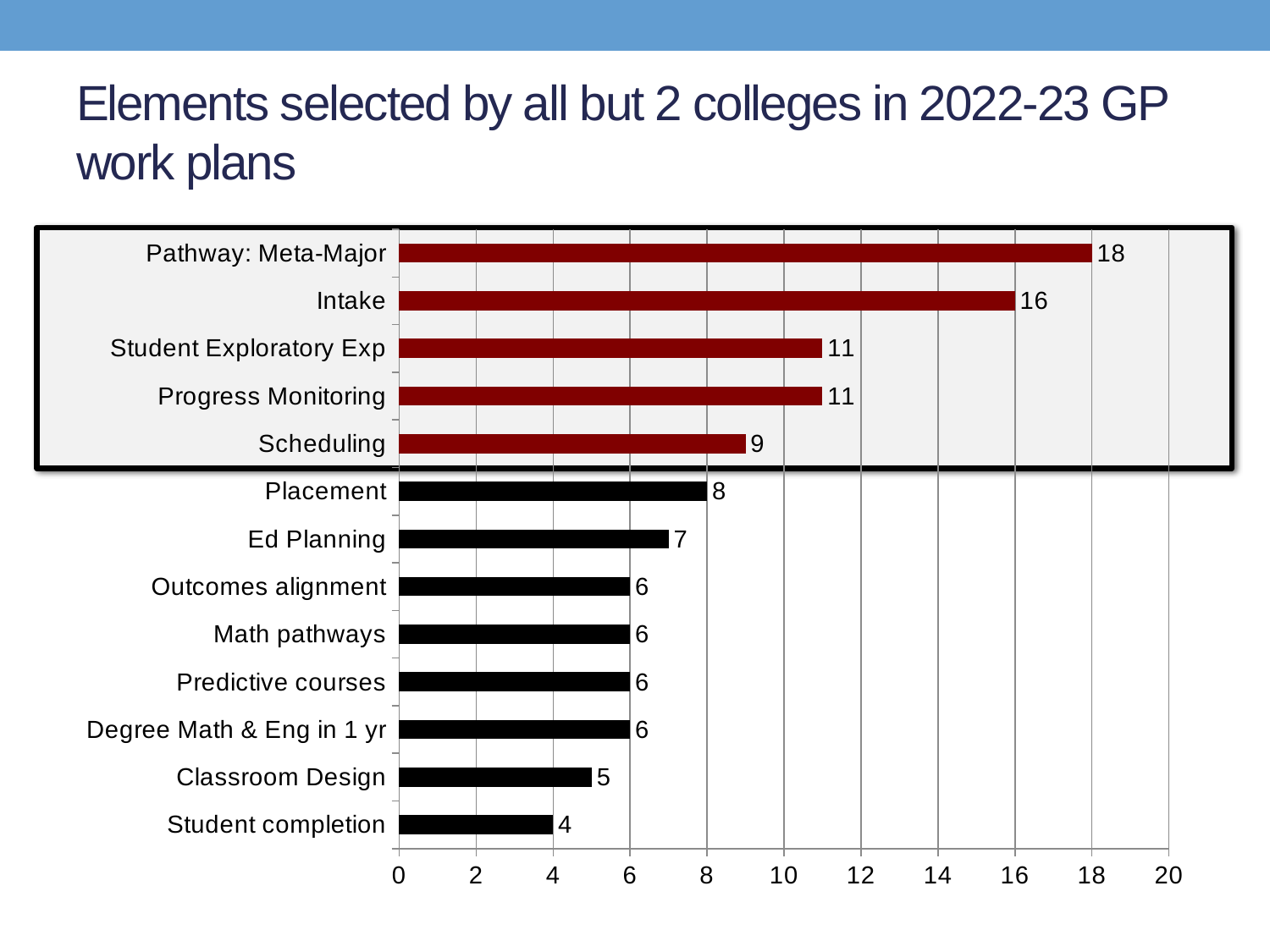
Is the value for Intake greater or less than 14? greater What is the value for Scheduling? 9 What is the difference between the values for Intake and Placement? 8 What is the value for Classroom Design? 5 How many categories are highlighted in the boxed area at the top of the chart? 5 What kind of chart is shown on the slide? bar chart Which category has the lowest value? Student completion What is the difference between the values for Pathway: Meta-Major and Student completion? 14 Which is larger, the value for Ed Planning or the value for Student Exploratory Exp? Student Exploratory Exp Which category has the highest value? Pathway: Meta-Major How many categories are shown in the chart? 13 What is the value for Pathway: Meta-Major? 18